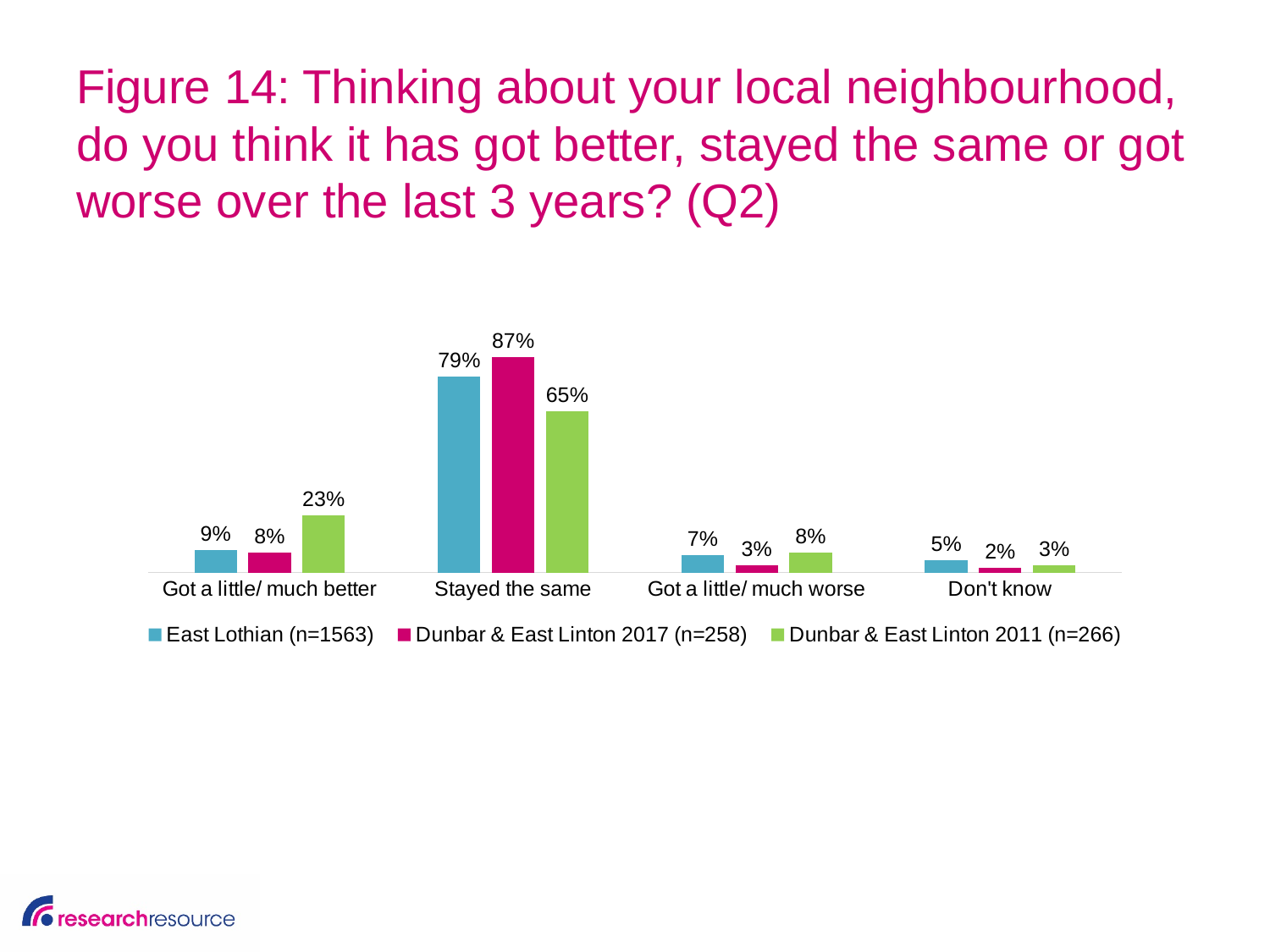
What percentage of Dunbar & East Linton 2017 respondents answered 'Don't know'? 2% What is the difference between the Dunbar & East Linton 2017 and Dunbar & East Linton 2011 values for 'Stayed the same'? 22% What percentage of East Lothian respondents said their neighbourhood stayed the same? 79% How many series does the legend list? 3 How many response categories are shown on the x axis? 4 In the 'Got a little/ much worse' category, which series has the larger value: East Lothian or Dunbar & East Linton 2011? Dunbar & East Linton 2011 Which category has the lowest value for the East Lothian series? Don't know What kind of chart is shown on the slide? Bar chart What is the value for Dunbar & East Linton 2011 in the 'Got a little/ much better' category? 23% What is the sample size (n) for the East Lothian series shown in the legend? 1563 What colour are the bars for the Dunbar & East Linton 2017 series? Pink Which category has the highest value for the Dunbar & East Linton 2017 series? Stayed the same